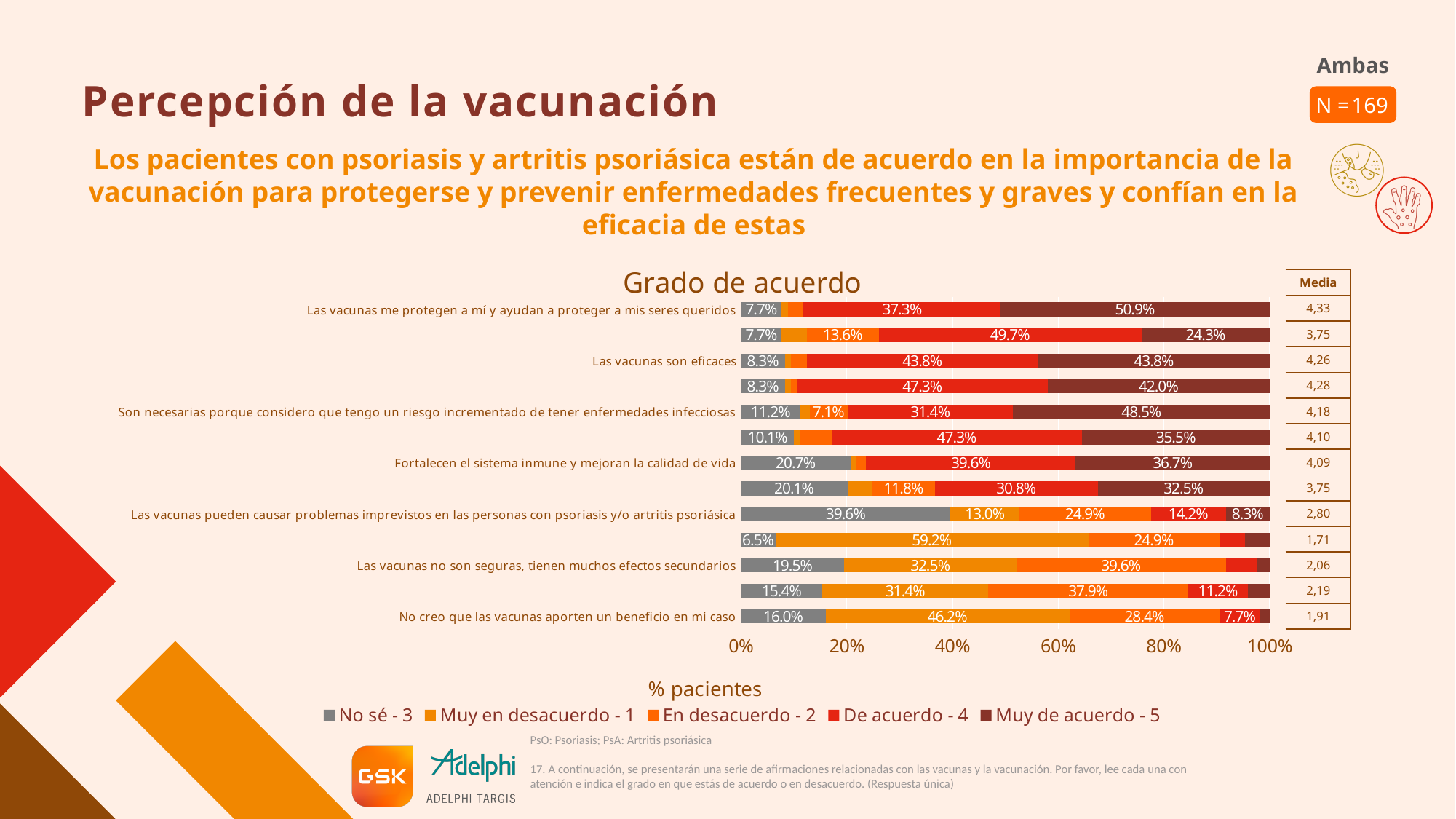
What is the "Muy de acuerdo - 5" value for "Las vacunas me protegen a mí y ayudan a proteger a mis seres queridos"? 50.9% What is the x-axis title of the "Grado de acuerdo" chart? % pacientes Which has a larger "Muy de acuerdo - 5" share: "Las vacunas me protegen a mí y ayudan a proteger a mis seres queridos" or "Las vacunas son eficaces"? Las vacunas me protegen a mí y ayudan a proteger a mis seres queridos What is the "En desacuerdo - 2" value for "Las vacunas no son seguras, tienen muchos efectos secundarios"? 39.6% Which labelled statement has the largest "No sé - 3" share? Las vacunas pueden causar problemas imprevistos en las personas con psoriasis y/o artritis psoriásica What kind of chart is shown under the title "Grado de acuerdo"? Stacked bar chart How many series does the legend of the "Grado de acuerdo" chart list? 5 What is the "No sé - 3" value for "Las vacunas pueden causar problemas imprevistos en las personas con psoriasis y/o artritis psoriásica"? 39.6% What is the "Muy en desacuerdo - 1" value for "No creo que las vacunas aporten un beneficio en mi caso"? 46.2% What is the "No sé - 3" value for "Fortalecen el sistema inmune y mejoran la calidad de vida"? 20.7% For "Las vacunas me protegen a mí y ayudan a proteger a mis seres queridos", what is the difference between the "Muy de acuerdo - 5" and "De acuerdo - 4" values? 13.6% What is the "Media" value shown for "Las vacunas son eficaces"? 4,26